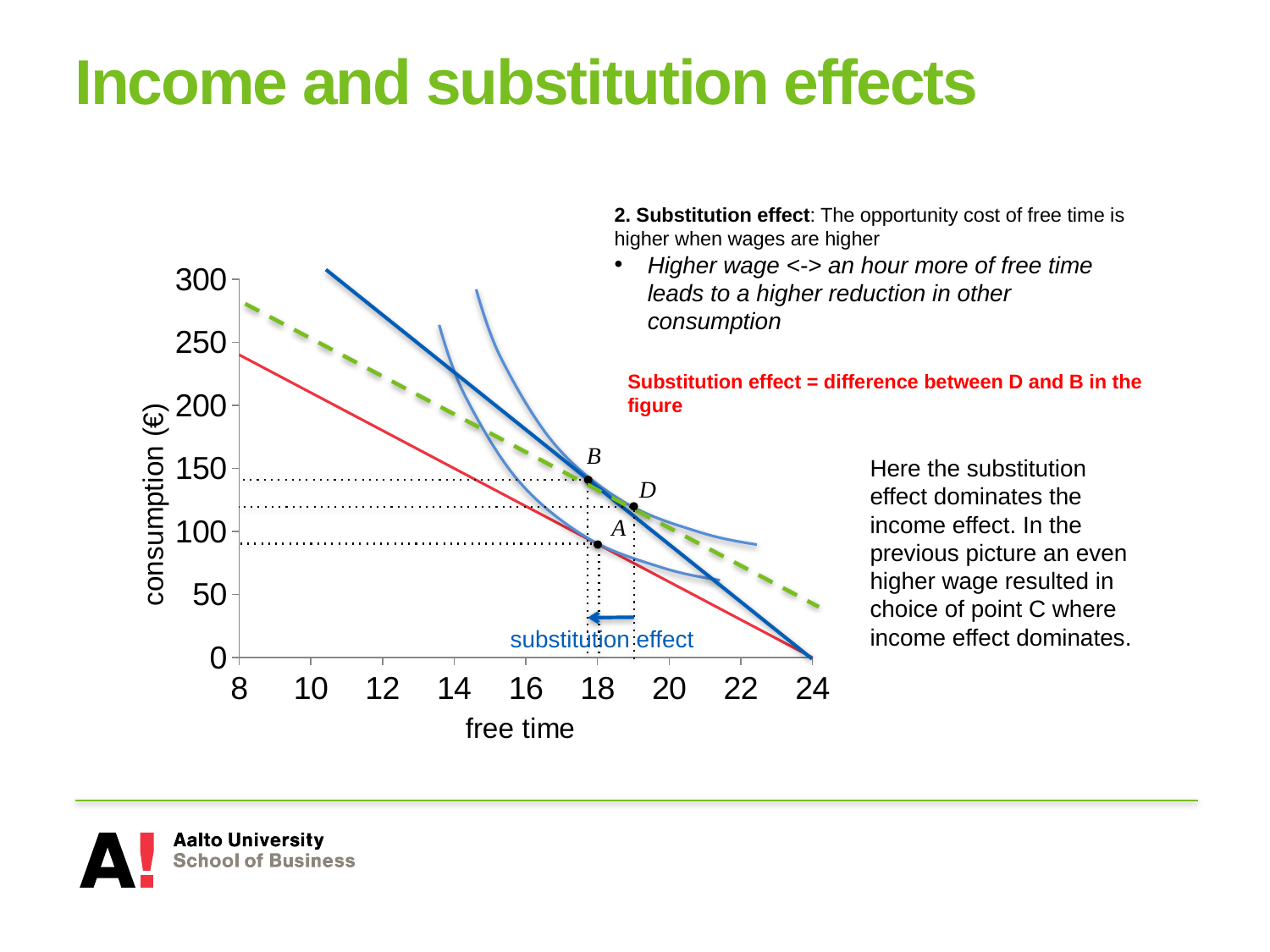
Which labelled point on the chart has the highest consumption? B What is the label of the x axis of the chart? free time What kind of chart is shown on the slide? line chart How many labelled points (marked with letters) are shown on the chart? 3 Which point has the higher consumption, B or D? B Is the consumption value at point D greater or less than 150? less Which labelled point on the chart has the lowest consumption? A Is the consumption value at point A greater or less than 100? less Which point has more free time, B or D? D Is the consumption value at point B greater or less than 100? greater At what free time value do the red and blue budget lines reach zero consumption? 24 What is the label of the y axis of the chart? consumption (€)